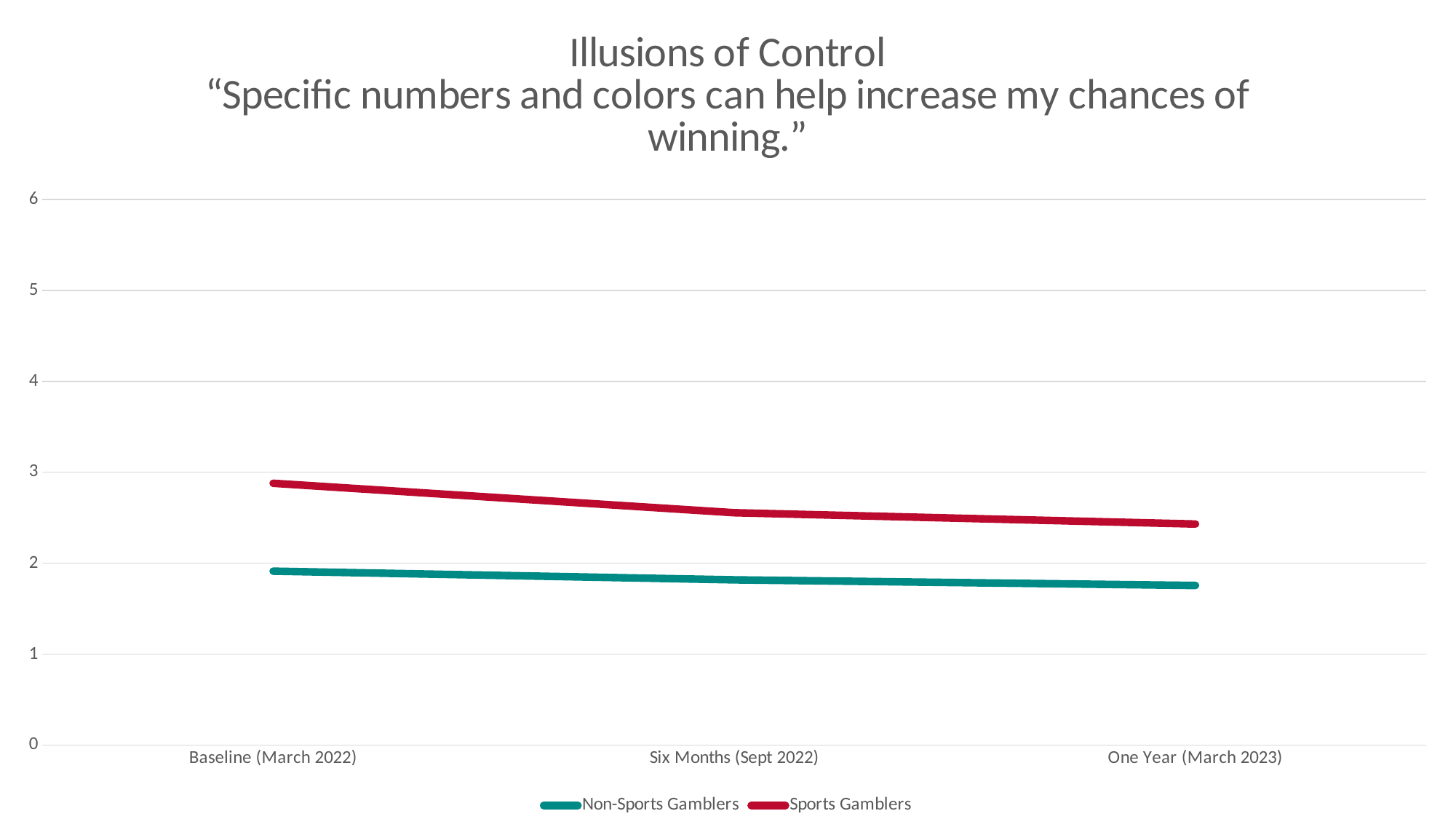
How many time points are plotted along the x axis? 3 Is the value for Non-Sports Gamblers at One Year (March 2023) greater or less than 2? less Is the value for Non-Sports Gamblers at Six Months (Sept 2022) greater or less than 1? greater What colour is the line for Sports Gamblers? red Do the values for Sports Gamblers rise or fall from Baseline (March 2022) to One Year (March 2023)? fall Do the values for Non-Sports Gamblers rise or fall across the three time points? fall Which series has the lower value at One Year (March 2023)? Non-Sports Gamblers What kind of chart is shown on the slide? line chart Is the value for Sports Gamblers at Baseline (March 2022) greater or less than 3? less How many series does the legend list? 2 Which series has the higher value at Baseline (March 2022): Non-Sports Gamblers or Sports Gamblers? Sports Gamblers